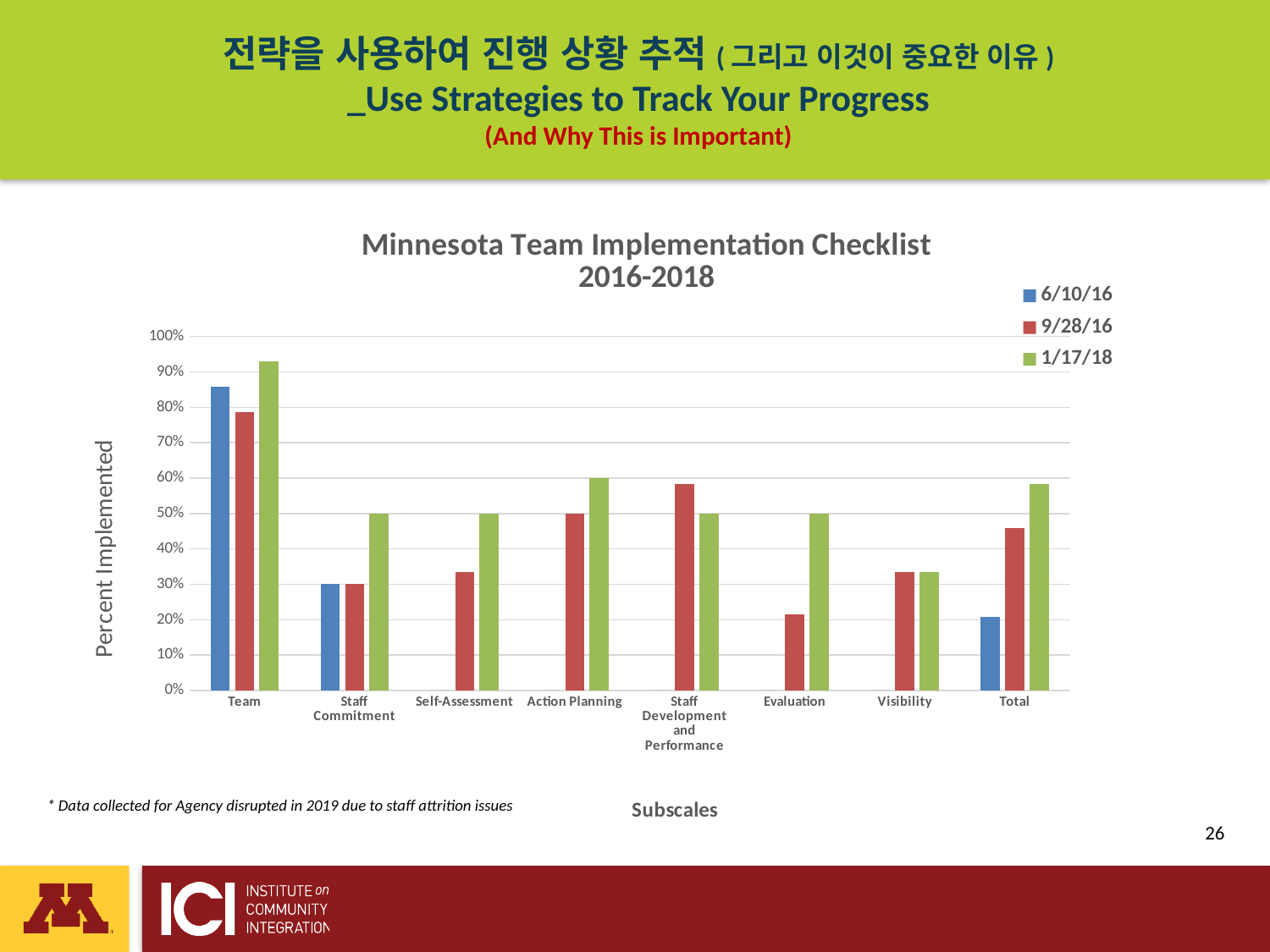
What is the label of the y axis? Percent Implemented Which subscale has the lowest value for the 1/17/18 series? Visibility What kind of chart is shown on the slide? bar chart How many subscale categories are shown on the x axis? 8 Is the value for Team on 1/17/18 greater or less than 90%? greater Which subscale has the highest value for the 1/17/18 series? Team Is the value for Total on 6/10/16 greater or less than 30%? less How many series does the legend list? 3 What is the title of the chart? Minnesota Team Implementation Checklist 2016-2018 For Team, which is larger: the 6/10/16 value or the 9/28/16 value? 6/10/16 For Total, which is larger: the 9/28/16 value or the 1/17/18 value? 1/17/18 Is the value for Evaluation on 9/28/16 greater or less than 30%? less